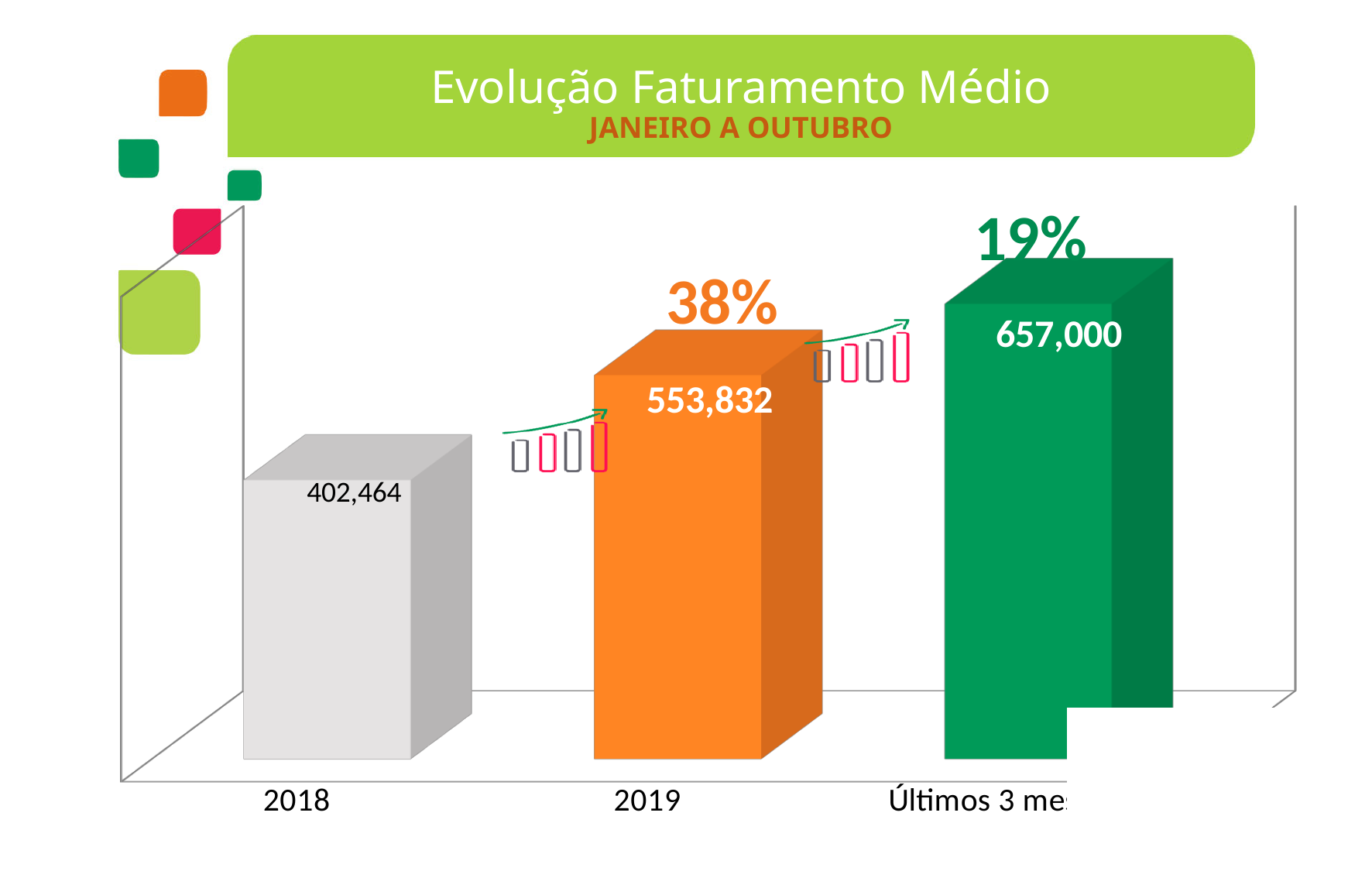
Which category has the highest value? Últimos 3 mes… (the third, green bar) What is the difference between the 2019 value and the 2018 value? 151,368 Do the values rise or fall from left to right across the chart? Rise What percentage is printed above the 2019 bar? 38% What is the value shown on the third (green) bar, labelled "Últimos 3 mes…"? 657,000 What is the difference between the third (green) bar's value and the 2019 value? 103,168 What is the value shown for 2019? 553,832 What is the value shown for 2018? 402,464 Which category has the lowest value? 2018 What kind of chart is shown on the slide? Bar chart How many bars are plotted in the chart? 3 Which is larger, the value for 2019 or the value for 2018? 2019